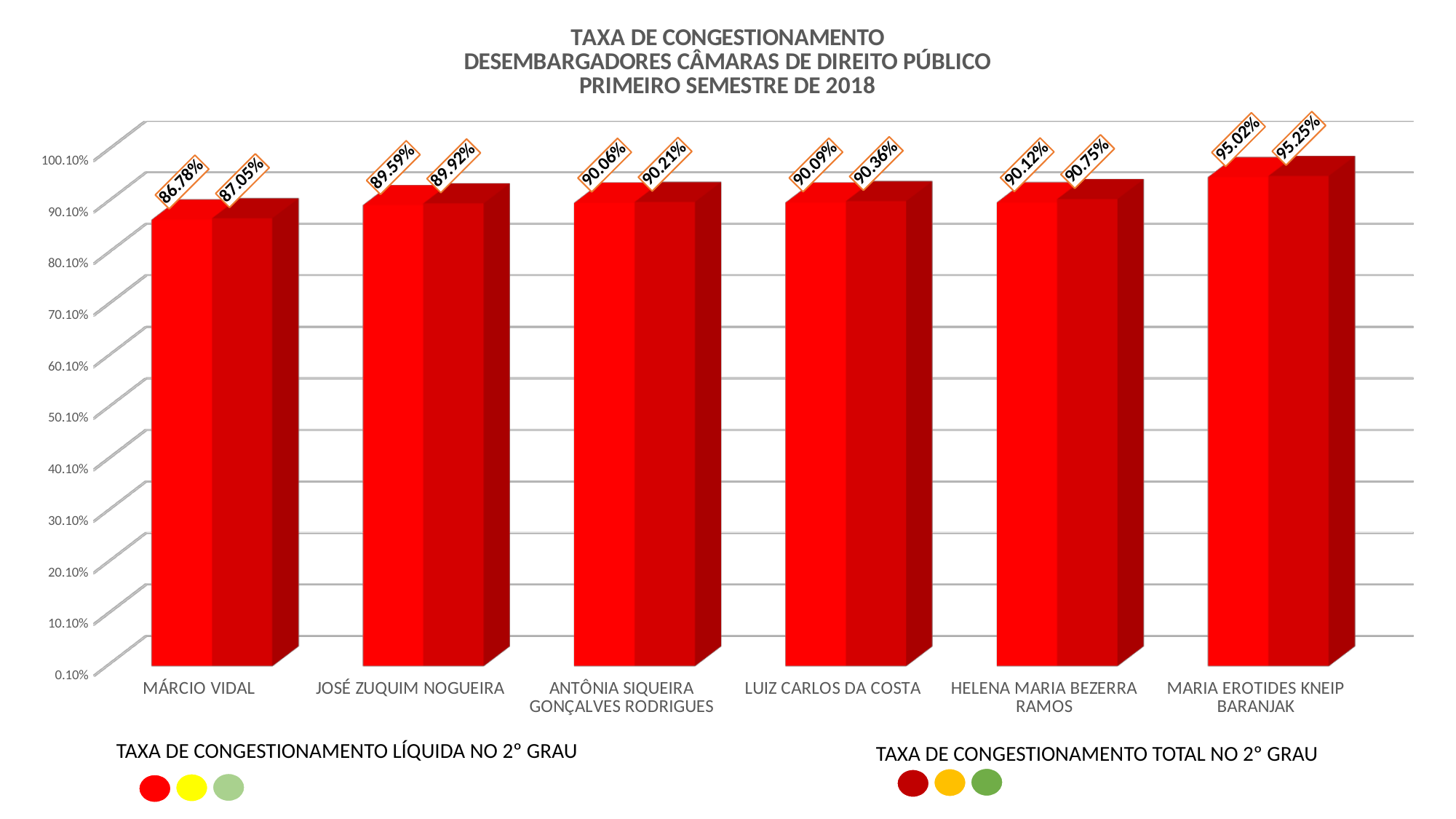
Which desembargador has the highest taxa de congestionamento total no 2° grau? Maria Erotides Kneip Baranjak What is the difference between the taxa de congestionamento total and the taxa de congestionamento líquida for Maria Erotides Kneip Baranjak? 0.23% How many series does the chart's legend list? 2 How many desembargadores are shown on the x axis of the chart? 6 What is the taxa de congestionamento líquida no 2° grau for Márcio Vidal? 86.78% What is the taxa de congestionamento total no 2° grau for Helena Maria Bezerra Ramos? 90.75% What kind of chart is shown on the slide? Bar chart Which desembargador has the lowest taxa de congestionamento líquida no 2° grau? Márcio Vidal What is the taxa de congestionamento líquida no 2° grau for Luiz Carlos da Costa? 90.09% Which is larger: the taxa de congestionamento líquida no 2° grau for Márcio Vidal or for José Zuquim Nogueira? José Zuquim Nogueira What is the taxa de congestionamento total no 2° grau for José Zuquim Nogueira? 89.92% What is the difference between the taxa de congestionamento líquida no 2° grau of Maria Erotides Kneip Baranjak and Márcio Vidal? 8.24%